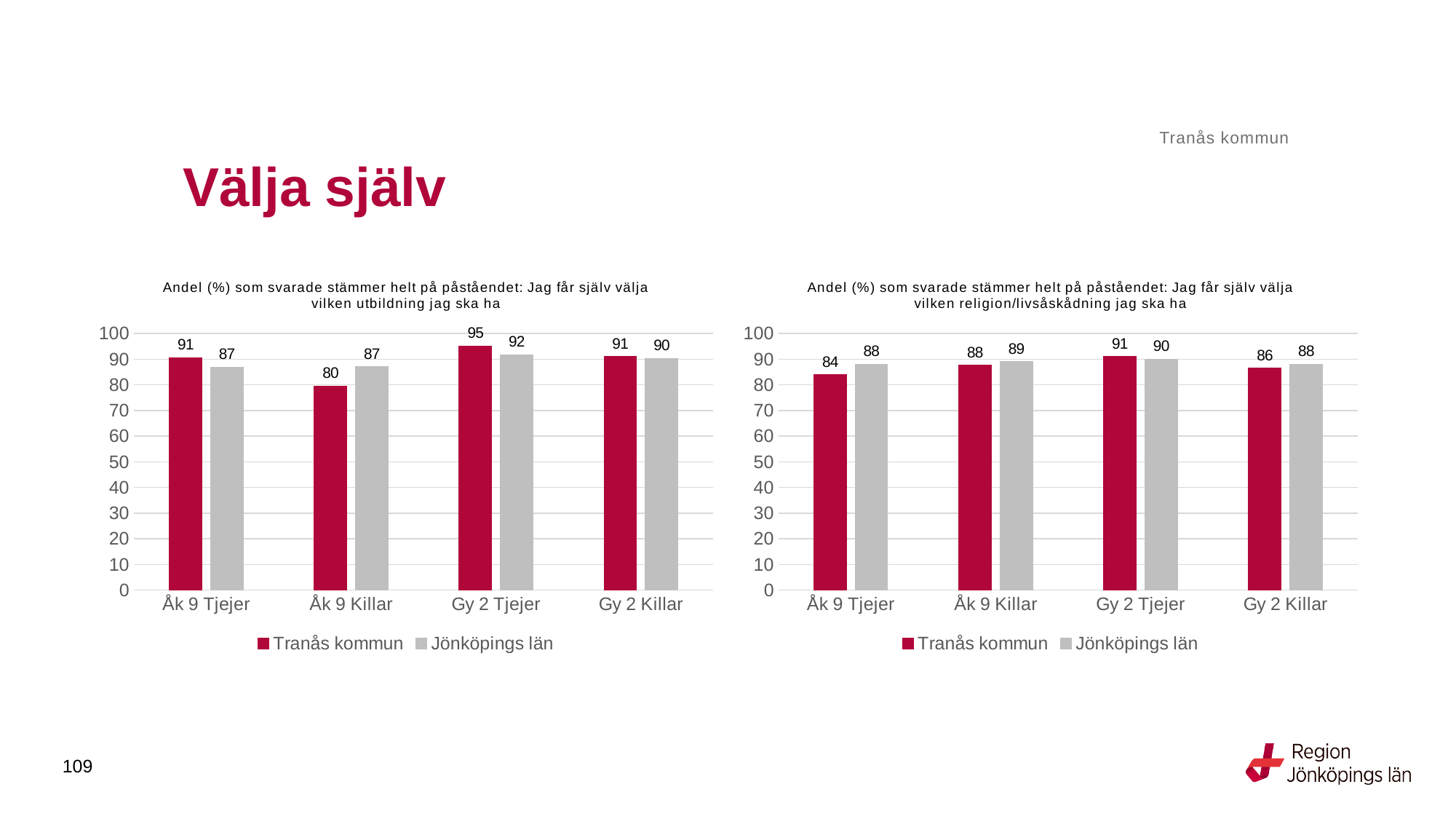
In the left chart (about choosing education), what is the difference between Tranås kommun and Jönköpings län for Åk 9 Killar? 7 How many series does the legend of the right chart list? 2 In the left chart (about choosing education), which is larger for Gy 2 Tjejer: Tranås kommun or Jönköpings län? Tranås kommun In the right chart (about choosing religion/livsåskådning), what is the value for Jönköpings län for Gy 2 Tjejer? 90 What kind of chart is the left chart? Bar chart In the right chart (about choosing religion/livsåskådning), what is the difference between Jönköpings län and Tranås kommun for Åk 9 Tjejer? 4 In the left chart (about choosing education), which category has the highest value for Tranås kommun? Gy 2 Tjejer In the right chart (about choosing religion/livsåskådning), which is larger for Gy 2 Killar: Tranås kommun or Jönköpings län? Jönköpings län How many categories are shown on the x axis of the left chart? 4 In the left chart, which colour represents Tranås kommun? Red In the right chart (about choosing religion/livsåskådning), which category has the lowest value for Tranås kommun? Åk 9 Tjejer In the left chart (about choosing education), what is the value for Tranås kommun for Åk 9 Killar? 80